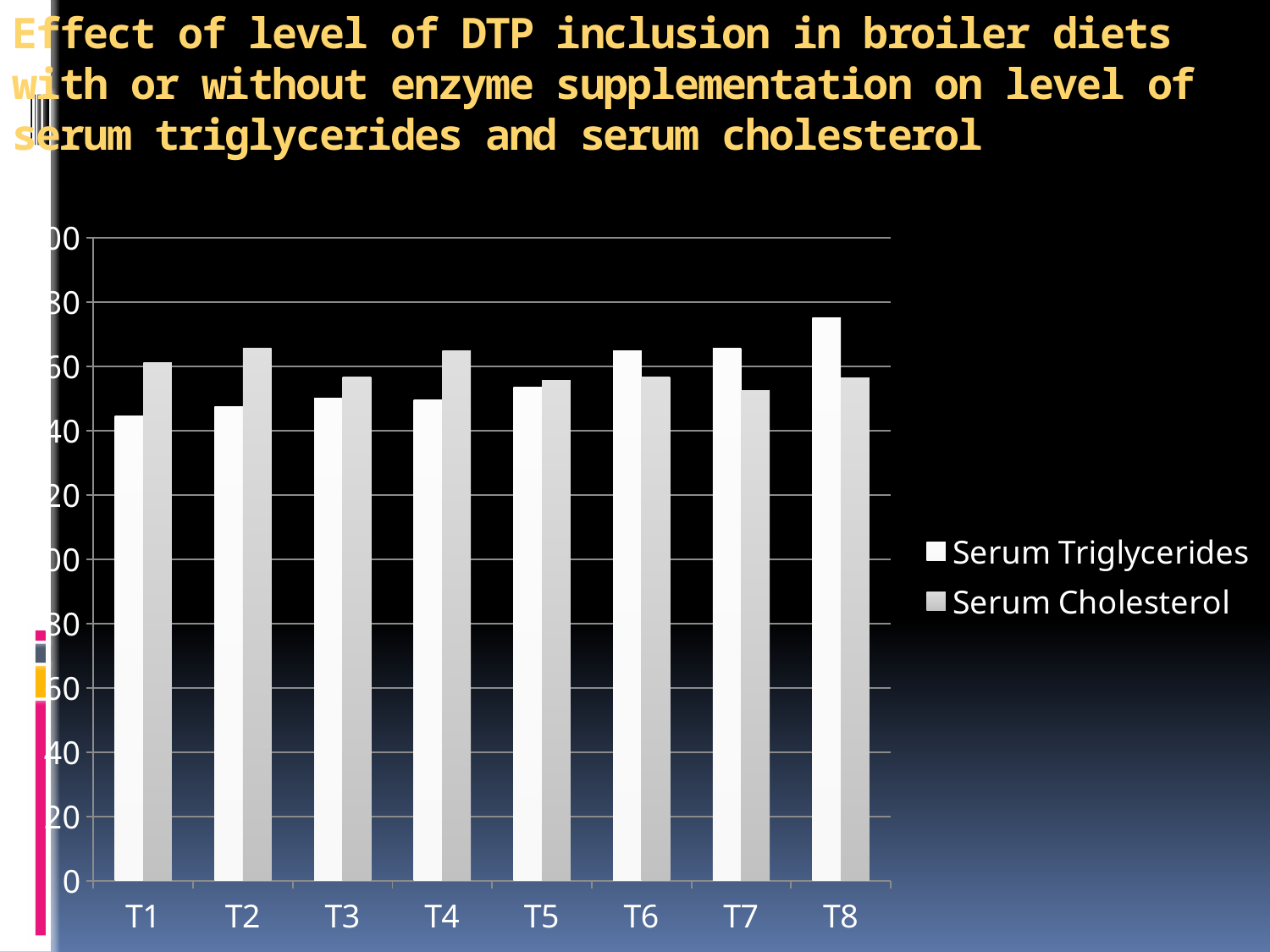
Which treatment has the highest Serum Triglycerides value? T8 Is the Serum Triglycerides value for T1 greater or less than 160? less For T8, which is larger: Serum Triglycerides or Serum Cholesterol? Serum Triglycerides How many treatment categories are shown on the x axis? 8 How many series does the legend list? 2 Is the Serum Cholesterol value for T7 greater or less than 160? less Do the Serum Triglycerides values generally rise or fall from T1 to T8? rise What kind of chart is shown on the slide? Bar chart Which series are listed in the legend? Serum Triglycerides and Serum Cholesterol Is the Serum Triglycerides value for T8 greater or less than 160? greater For T1, which is larger: Serum Triglycerides or Serum Cholesterol? Serum Cholesterol